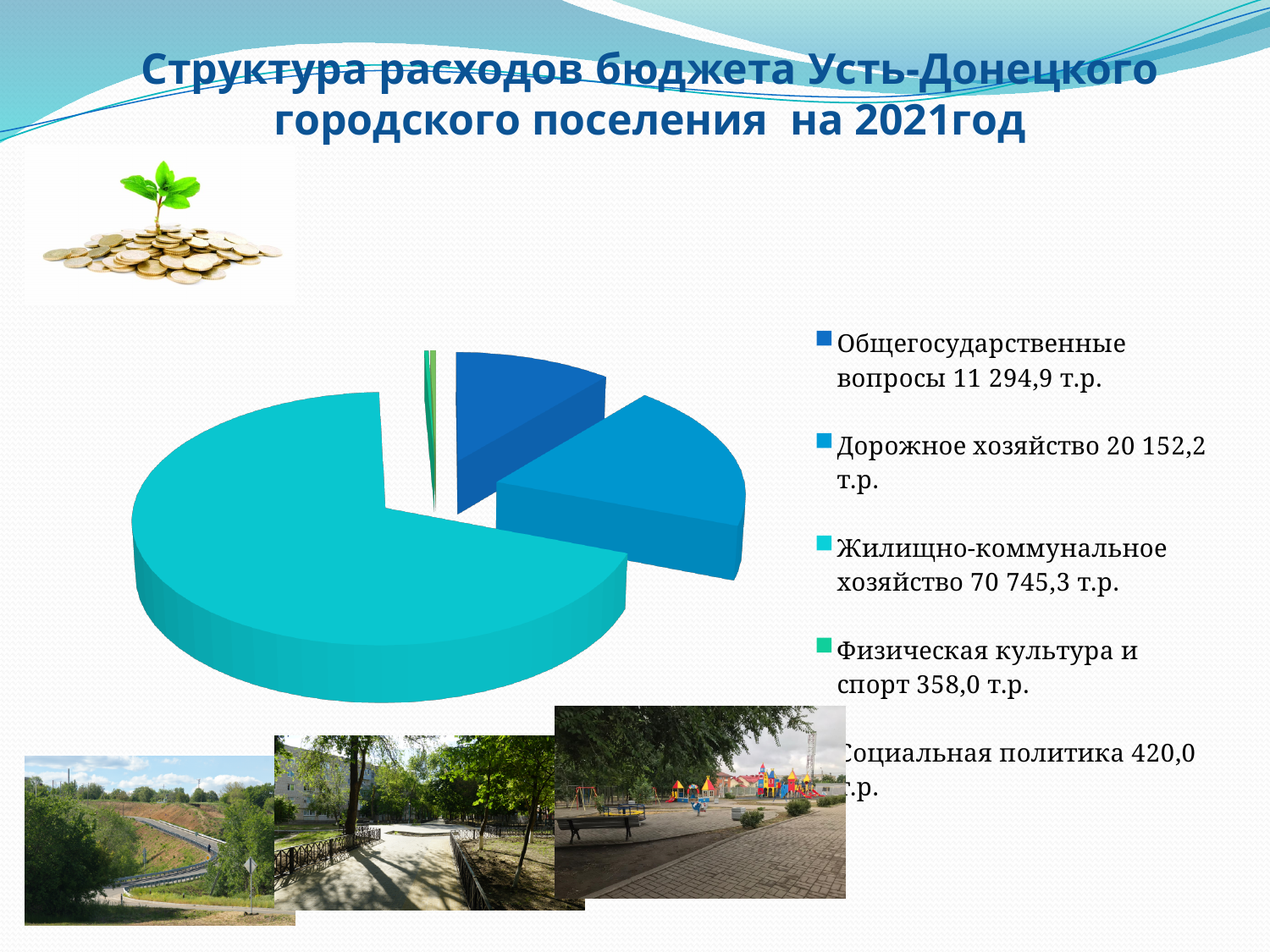
What kind of chart is shown on the slide? Pie chart What is the value for Жилищно-коммунальное хозяйство? 70 745,3 т.р. Which category has the largest share of the pie? Жилищно-коммунальное хозяйство What is the value for Физическая культура и спорт? 358,0 т.р. Which is larger: Дорожное хозяйство or Общегосударственные вопросы? Дорожное хозяйство What is the difference between Жилищно-коммунальное хозяйство and Дорожное хозяйство? 50 593,1 т.р. What is the value for Общегосударственные вопросы? 11 294,9 т.р. How many categories does the pie chart have? 5 Which category has the smallest value? Физическая культура и спорт What is the difference between Дорожное хозяйство and Общегосударственные вопросы? 8 857,3 т.р. What is the value for Дорожное хозяйство? 20 152,2 т.р. What colour is the slice for Жилищно-коммунальное хозяйство? Turquoise (light blue-green)